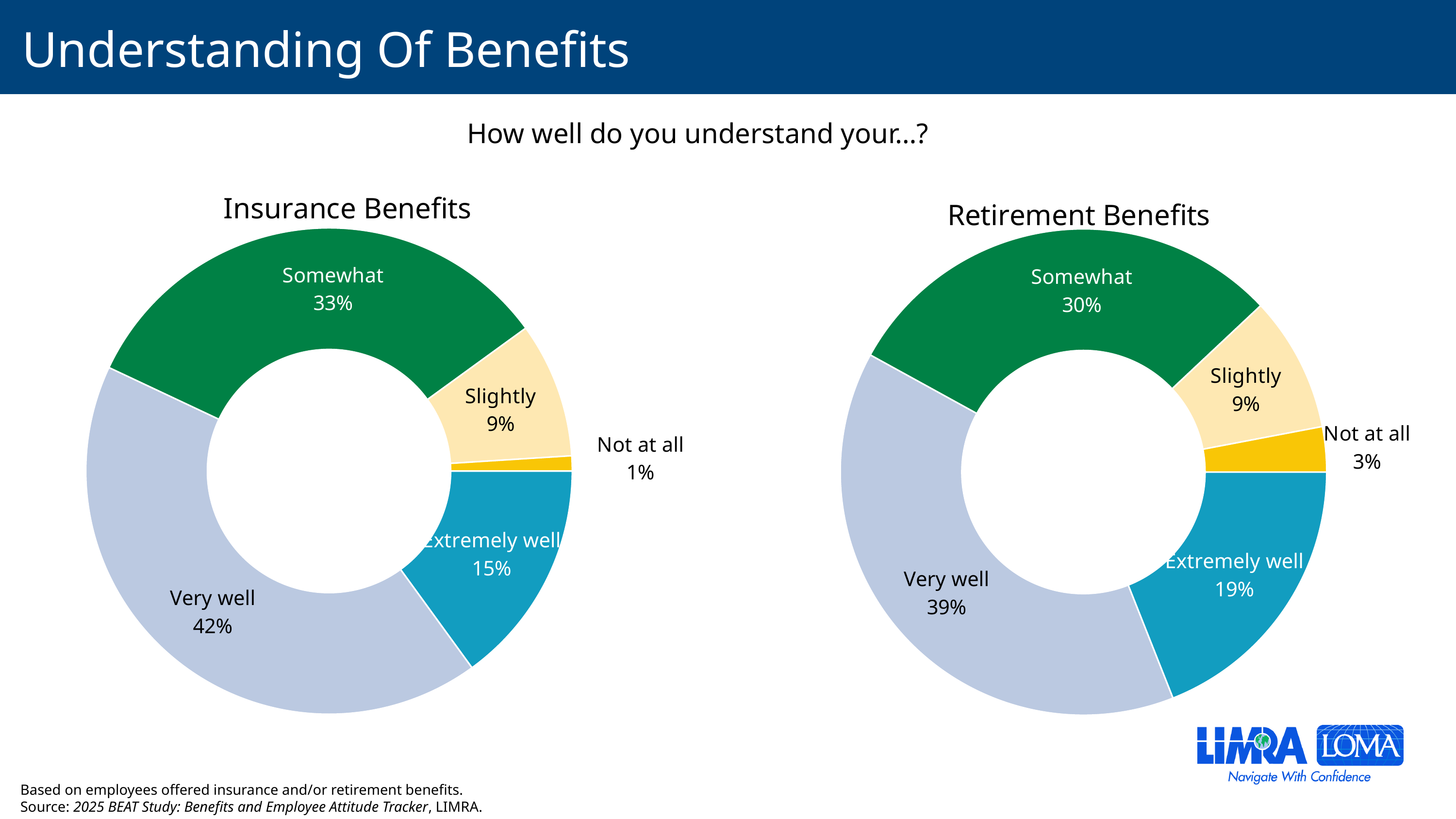
In the Retirement Benefits chart, what share of respondents said 'Extremely well'? 19% In the Insurance Benefits chart, what is the difference between the 'Somewhat' and 'Slightly' shares? 24 percentage points In the Retirement Benefits chart, which category has the largest share? Very well In the Retirement Benefits chart, what share of respondents said 'Not at all'? 3% Which is larger: 'Extremely well' in the Insurance Benefits chart or 'Extremely well' in the Retirement Benefits chart? Retirement Benefits What is the difference between the 'Very well' share in the Insurance Benefits chart and the 'Very well' share in the Retirement Benefits chart? 3 percentage points What type of chart is the Insurance Benefits chart? Doughnut (pie) chart In the Insurance Benefits chart, which category has the largest share? Very well In the Insurance Benefits chart, which category has the smallest share? Not at all What question is shown above the two charts? How well do you understand your...? In the Insurance Benefits chart, what share of respondents said they understand their benefits 'Very well'? 42% How many categories are shown in the Retirement Benefits chart? 5